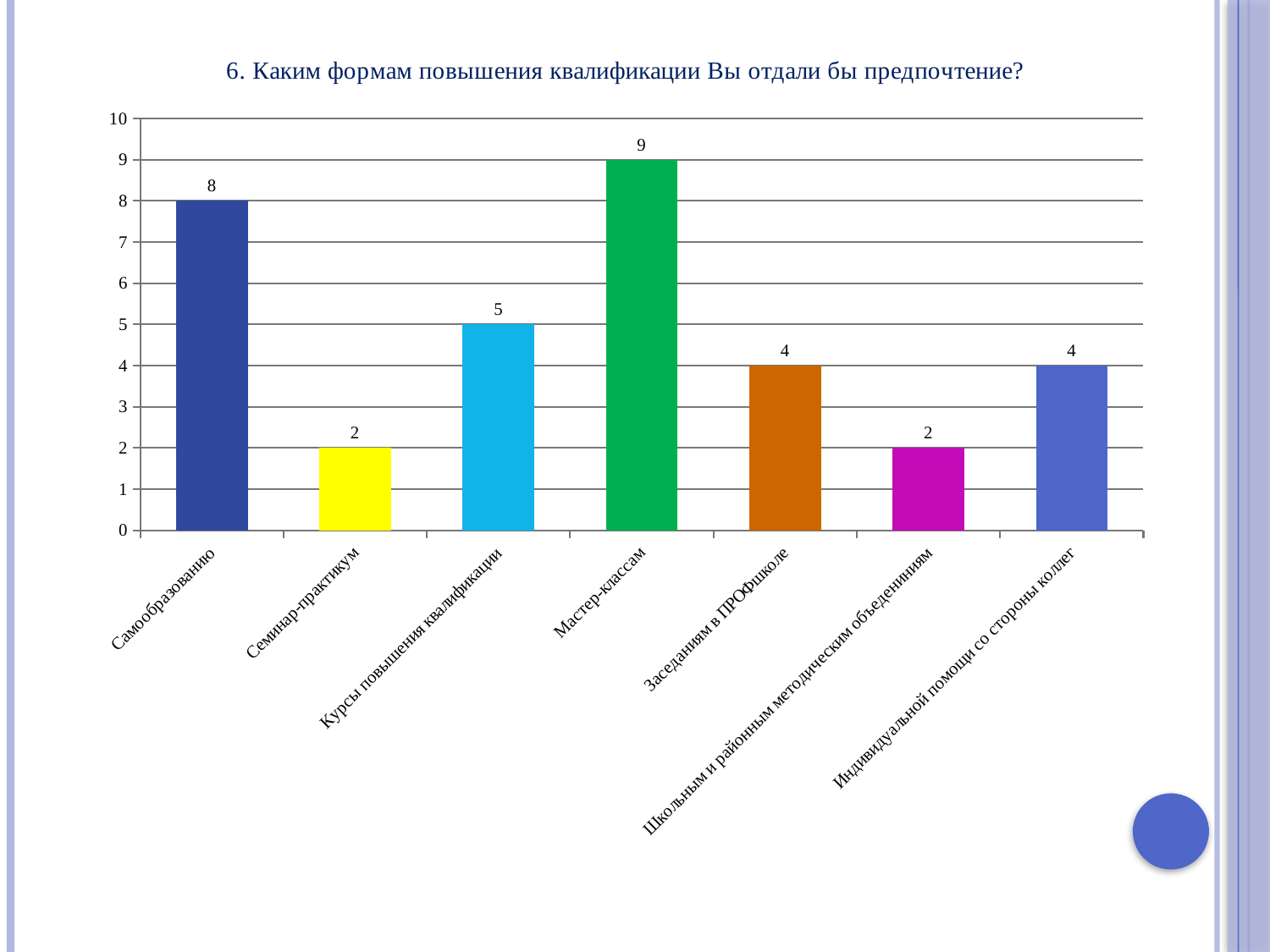
How many categories are shown on the chart? 7 What is the difference between the values for Мастер-классам and Самообразованию? 1 What kind of chart is shown on the slide? bar chart What is the title of the chart? 6. Каким формам повышения квалификации Вы отдали бы предпочтение? Is the value for Мастер-классам greater or less than 5? greater What is the value for Курсы повышения квалификации? 5 Which is larger, the value for Самообразованию or the value for Курсы повышения квалификации? Самообразованию What is the value for Самообразованию? 8 What is the value for Заседаниям в ПРОФшколе? 4 What is the difference between the values for Курсы повышения квалификации and Семинар-практикум? 3 What is the value for Мастер-классам? 9 Which category has the highest value? Мастер-классам